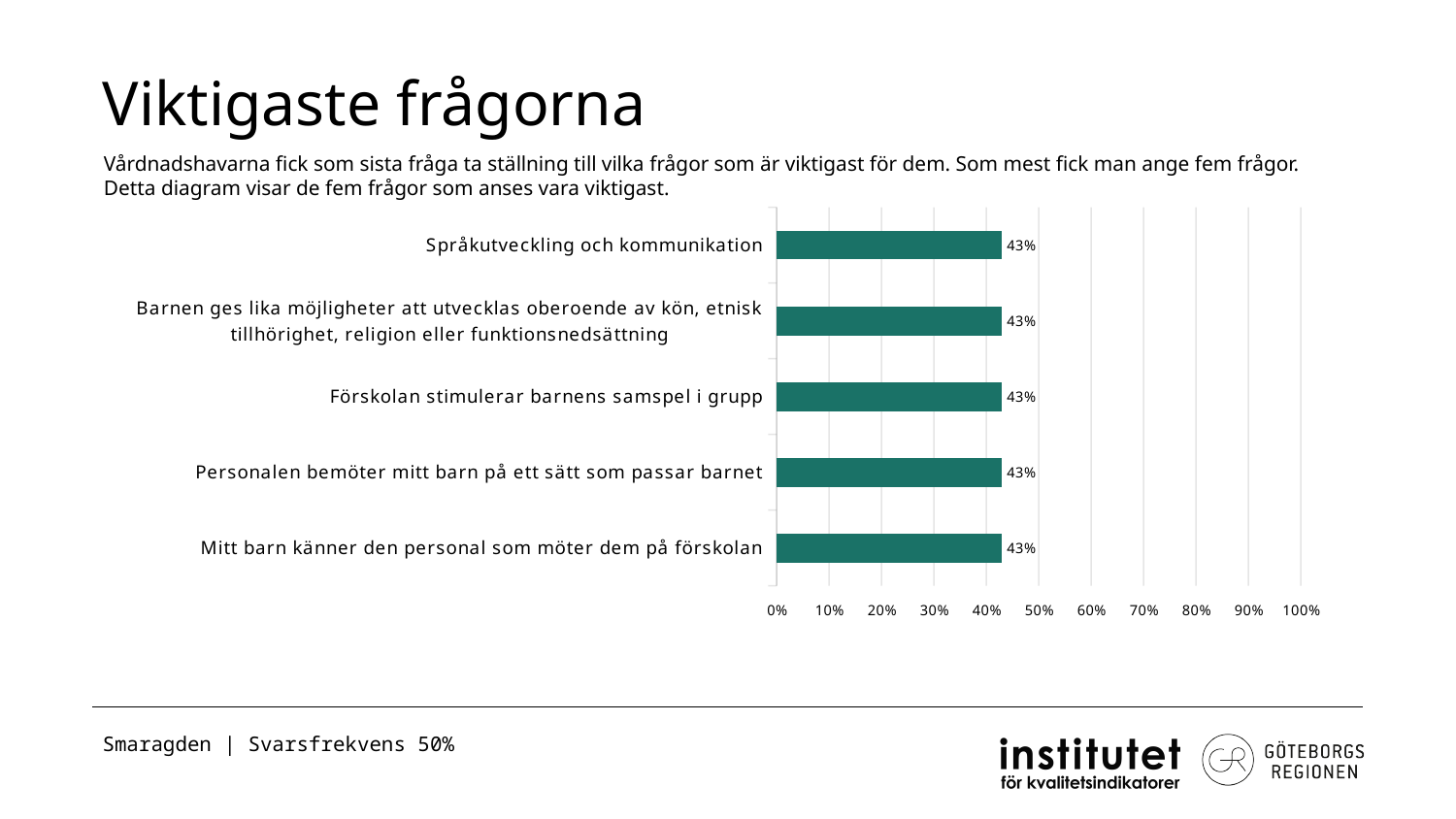
Is the value for Språkutveckling och kommunikation greater or less than 50%? less What is the value for Personalen bemöter mitt barn på ett sätt som passar barnet? 43% What is the value for Mitt barn känner den personal som möter dem på förskolan? 43% What kind of chart is shown on the slide? Bar chart What is the title of the slide containing the chart? Viktigaste frågorna What is the value for Barnen ges lika möjligheter att utvecklas oberoende av kön, etnisk tillhörighet, religion eller funktionsnedsättning? 43% What is the highest value shown on the x axis of the chart? 100% What is the difference between the values for Språkutveckling och kommunikation and Förskolan stimulerar barnens samspel i grupp? 0% What is the value for Förskolan stimulerar barnens samspel i grupp? 43% Is the value for Mitt barn känner den personal som möter dem på förskolan greater or less than 30%? greater What is the value for Språkutveckling och kommunikation? 43% How many categories are shown in the chart? 5